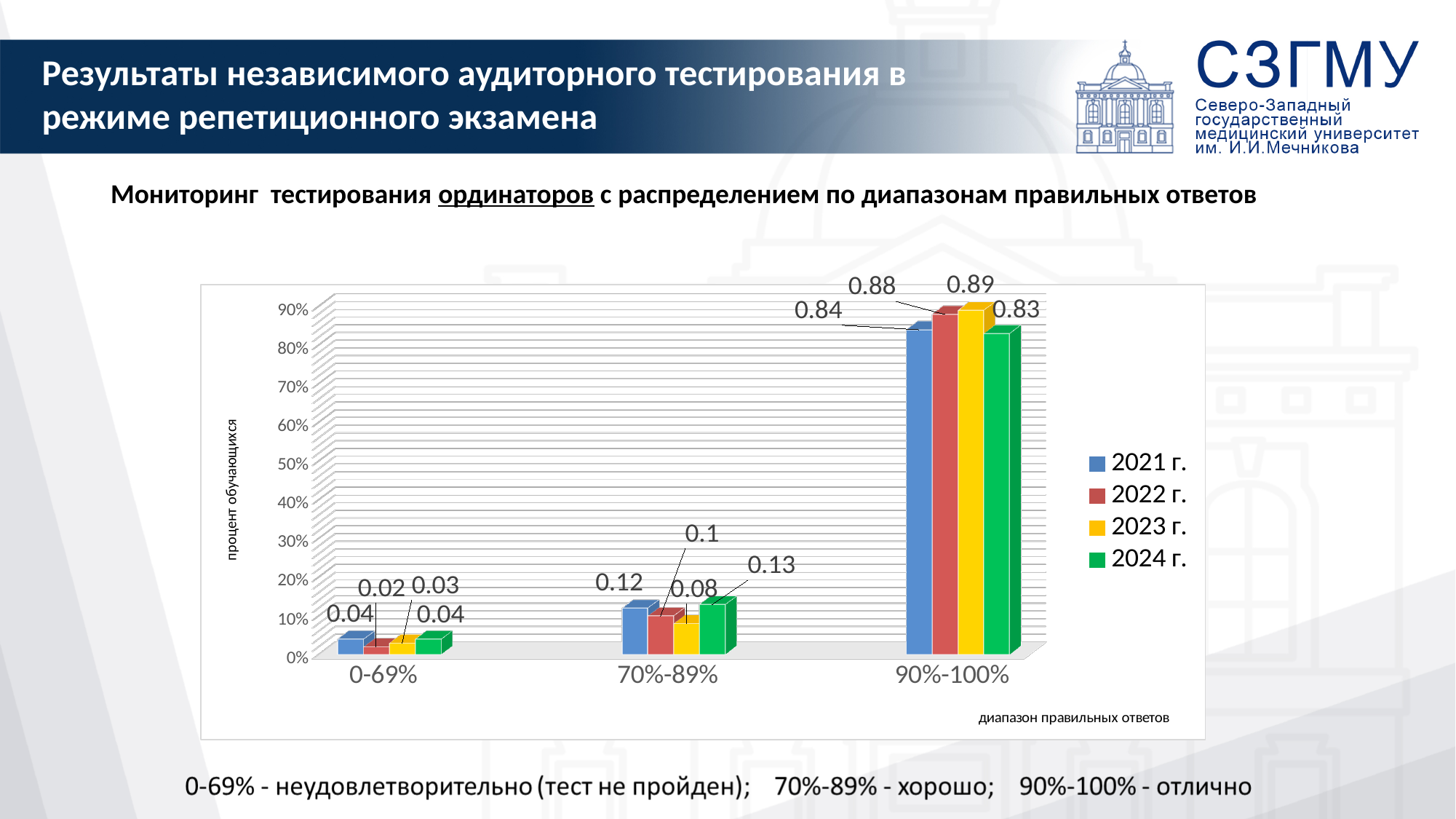
Is the value for 2024 г. in the 90%-100% category greater or less than 80%? greater What is the value for 2021 г. in the 90%-100% category? 0.84 Which is larger in the 70%-89% category: the value for 2021 г. or the value for 2023 г.? 2021 г. Which year has the highest value in the 90%-100% category? 2023 г. How many series does the legend list? 4 What kind of chart is shown on the slide? bar chart Which year has the lowest value in the 0-69% category? 2022 г. What is the label of the vertical axis? процент обучающихся What is the value for 2022 г. in the 0-69% category? 0.02 How many categories are shown on the x axis? 3 What is the value for 2023 г. in the 70%-89% category? 0.08 What is the difference between the 2024 г. and 2021 г. values in the 70%-89% category? 0.01